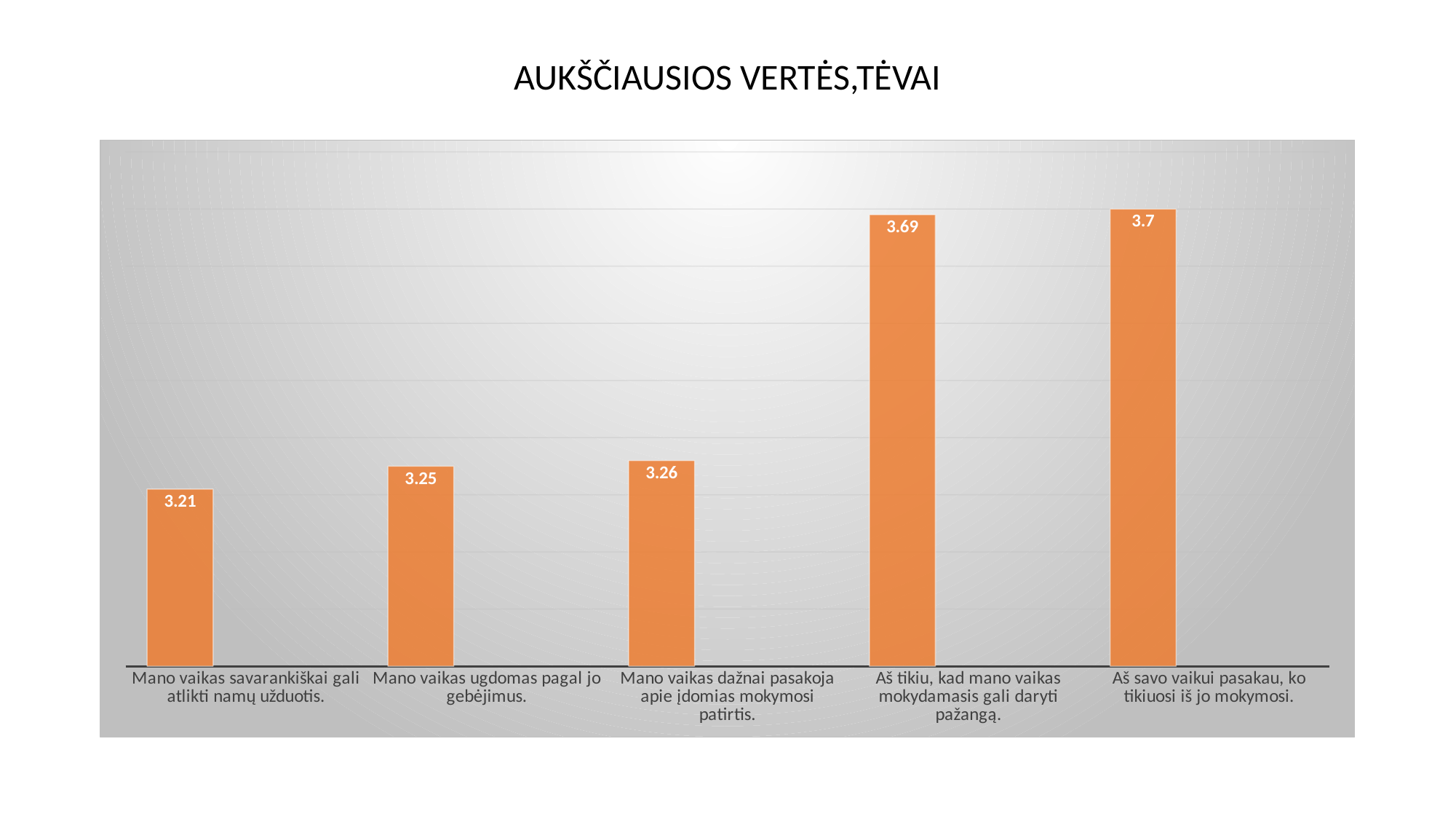
What is the difference between the values for "Aš savo vaikui pasakau, ko tikiuosi iš jo mokymosi." and "Mano vaikas savarankiškai gali atlikti namų užduotis."? 0.49 Which is larger: the value for "Aš tikiu, kad mano vaikas mokydamasis gali daryti pažangą." or for "Mano vaikas dažnai pasakoja apie įdomias mokymosi patirtis."? Aš tikiu, kad mano vaikas mokydamasis gali daryti pažangą. What is the value for "Aš tikiu, kad mano vaikas mokydamasis gali daryti pažangą."? 3.69 What kind of chart is shown on the slide? Bar chart What is the value for "Mano vaikas savarankiškai gali atlikti namų užduotis."? 3.21 What is the title of the slide? AUKŠČIAUSIOS VERTĖS,TĖVAI Which category has the lowest value? Mano vaikas savarankiškai gali atlikti namų užduotis. What is the value for "Mano vaikas ugdomas pagal jo gebėjimus."? 3.25 What is the value for "Mano vaikas dažnai pasakoja apie įdomias mokymosi patirtis."? 3.26 What is the value for "Aš savo vaikui pasakau, ko tikiuosi iš jo mokymosi."? 3.7 How many categories are shown in the chart? 5 Which category has the highest value? Aš savo vaikui pasakau, ko tikiuosi iš jo mokymosi.